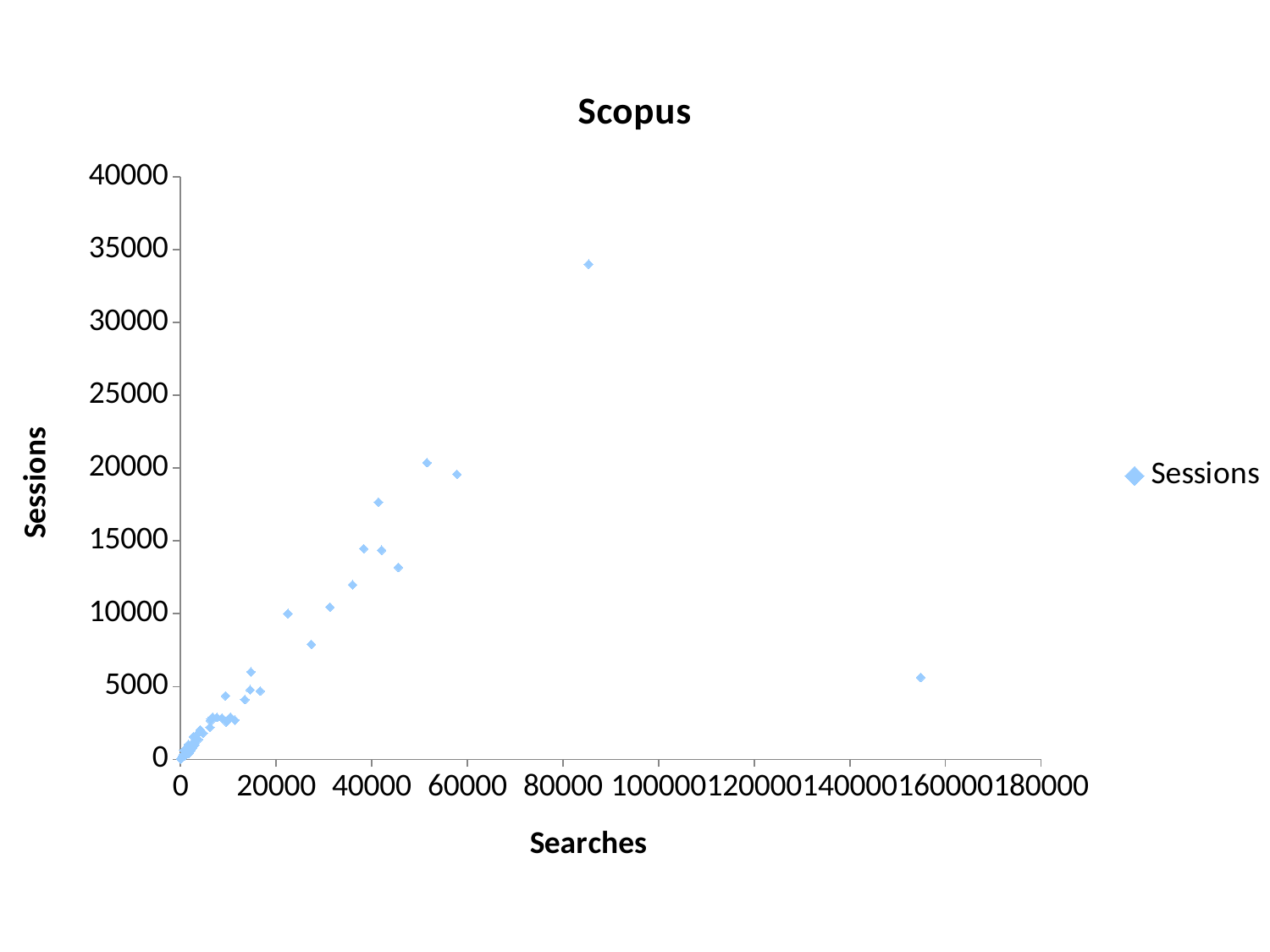
Is the Sessions value of the highest point on the chart greater or less than 30000? greater What are the labels of the x axis and the y axis? Searches (x axis) and Sessions (y axis) What kind of chart is shown on the slide? Scatter chart Is the Sessions value of the point with the largest Searches value greater or less than 10000? less Is the Searches value of the rightmost point greater or less than 140000? greater For the points with fewer than 60000 Searches, do Sessions generally rise or fall as Searches increase? rise What is the highest tick value shown on the x axis? 180000 What is the highest tick value shown on the y axis? 40000 What is the title of the chart? Scopus How many series does the legend list? 1 Does the point with the largest Searches value also have the largest Sessions value? No